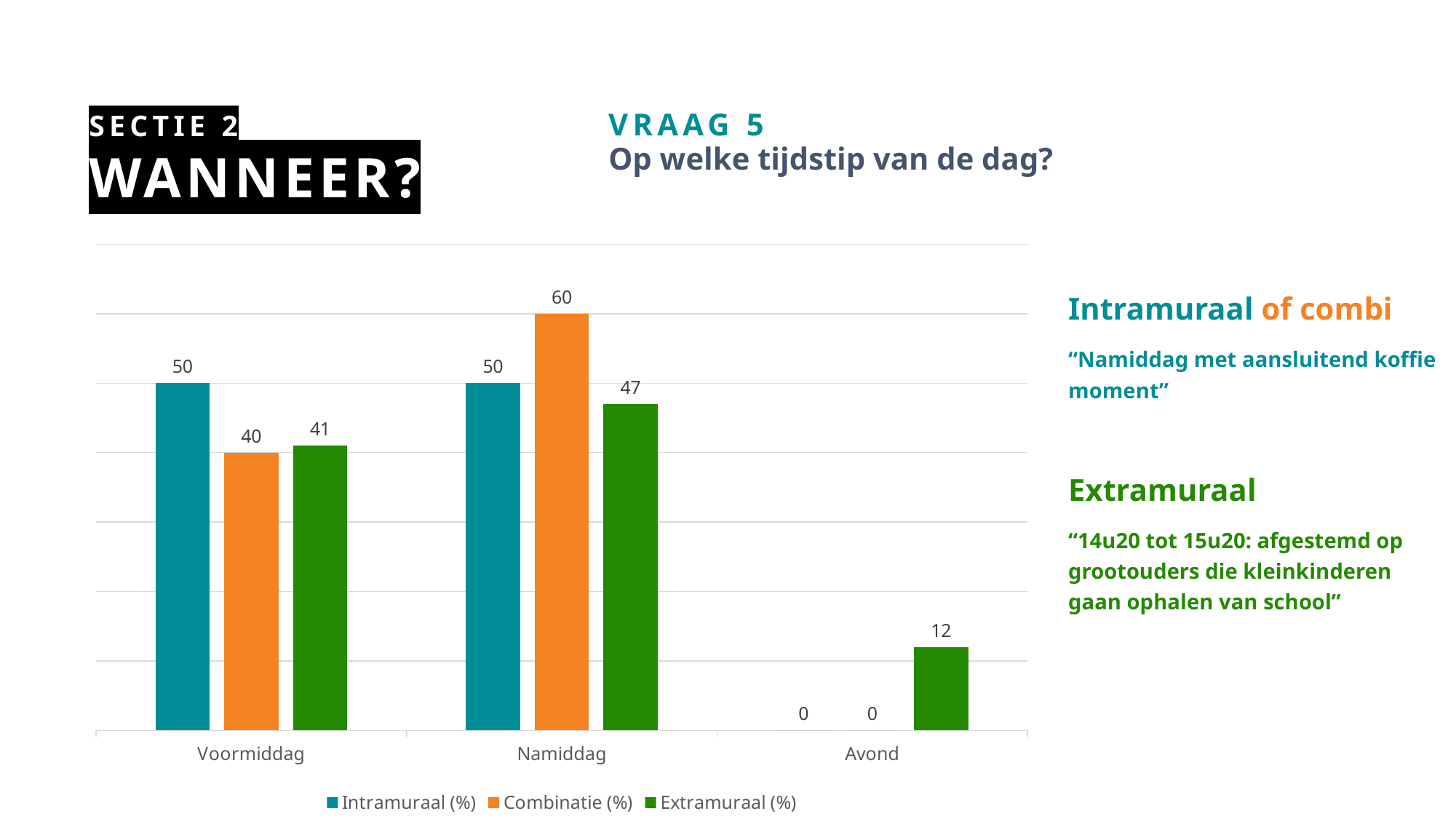
How many series does the legend list? 3 What kind of chart is shown on the slide? Bar chart Which category has the lowest value for Combinatie (%)? Avond Which is larger in the Voormiddag category: Combinatie (%) or Extramuraal (%)? Extramuraal (%) What is the value for Combinatie (%) in the Namiddag category? 60 What is the difference between the Combinatie (%) and Intramuraal (%) values in the Namiddag category? 10 What is the value for Intramuraal (%) in the Voormiddag category? 50 What is the value for Extramuraal (%) in the Avond category? 12 Which colour represents the Combinatie (%) series in the chart? Orange Which category has the highest value for Extramuraal (%)? Namiddag What is the value for Combinatie (%) in the Avond category? 0 How many categories are shown on the x axis? 3